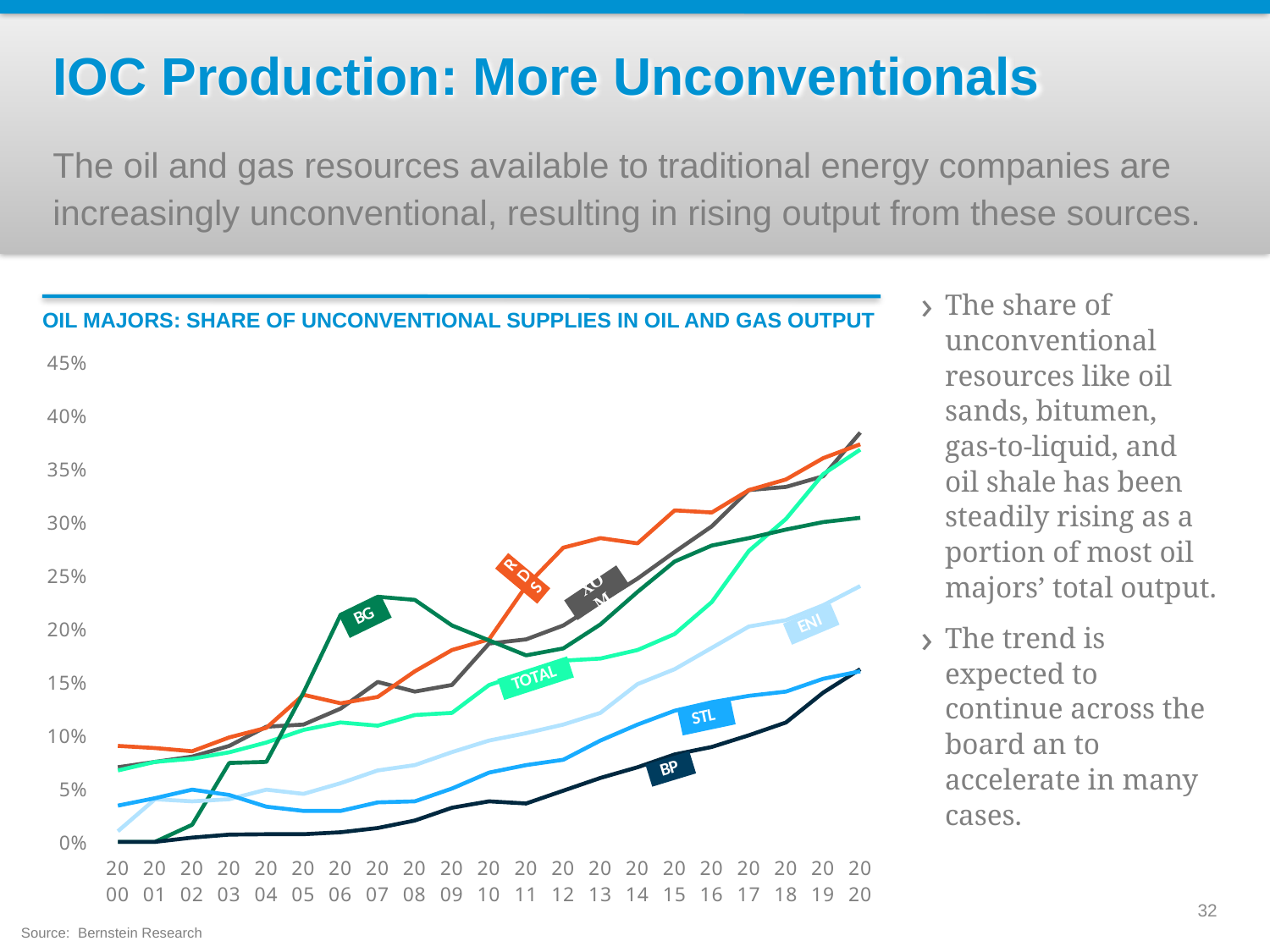
Is the value for ENI in 2020 greater or less than 20%? greater Is the value for BG in 2008 greater or less than 20%? greater Is the value for BP in 2005 greater or less than 5%? less Does the BP line rise or fall from 2000 to 2020? rise What kind of chart is shown on the slide? line chart Which company has the highest share in 2008? BG How many years are plotted along the x axis of the chart? 21 In 2020, which is larger, the value for TOTAL or the value for ENI? TOTAL What is the title of the chart? OIL MAJORS: SHARE OF UNCONVENTIONAL SUPPLIES IN OIL AND GAS OUTPUT How many company series are labelled on the chart? 7 Which company has the lowest share in 2005? BP